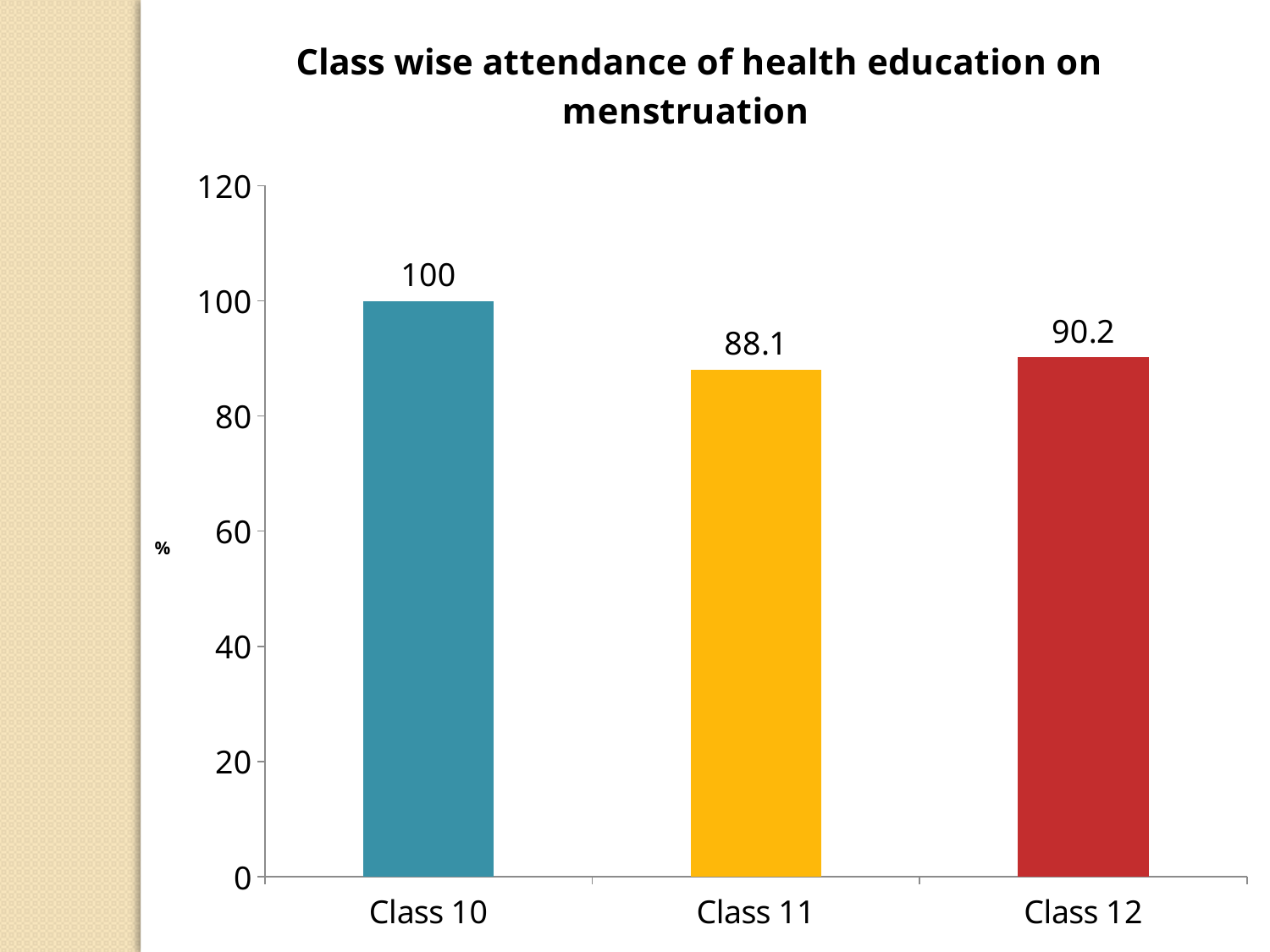
What is the difference between the attendance values for Class 10 and Class 11? 11.9 What is the title of the chart? Class wise attendance of health education on menstruation What is the attendance value for Class 10? 100 What is the attendance value for Class 11? 88.1 What kind of chart is shown on the slide? Bar chart How many classes are shown on the chart? 3 Which class has the lowest attendance? Class 11 Is the value for Class 11 greater or less than 100? less Which class has the highest attendance? Class 10 Which has a larger attendance value, Class 11 or Class 12? Class 12 What is the attendance value for Class 12? 90.2 What is the difference between the attendance values for Class 12 and Class 11? 2.1